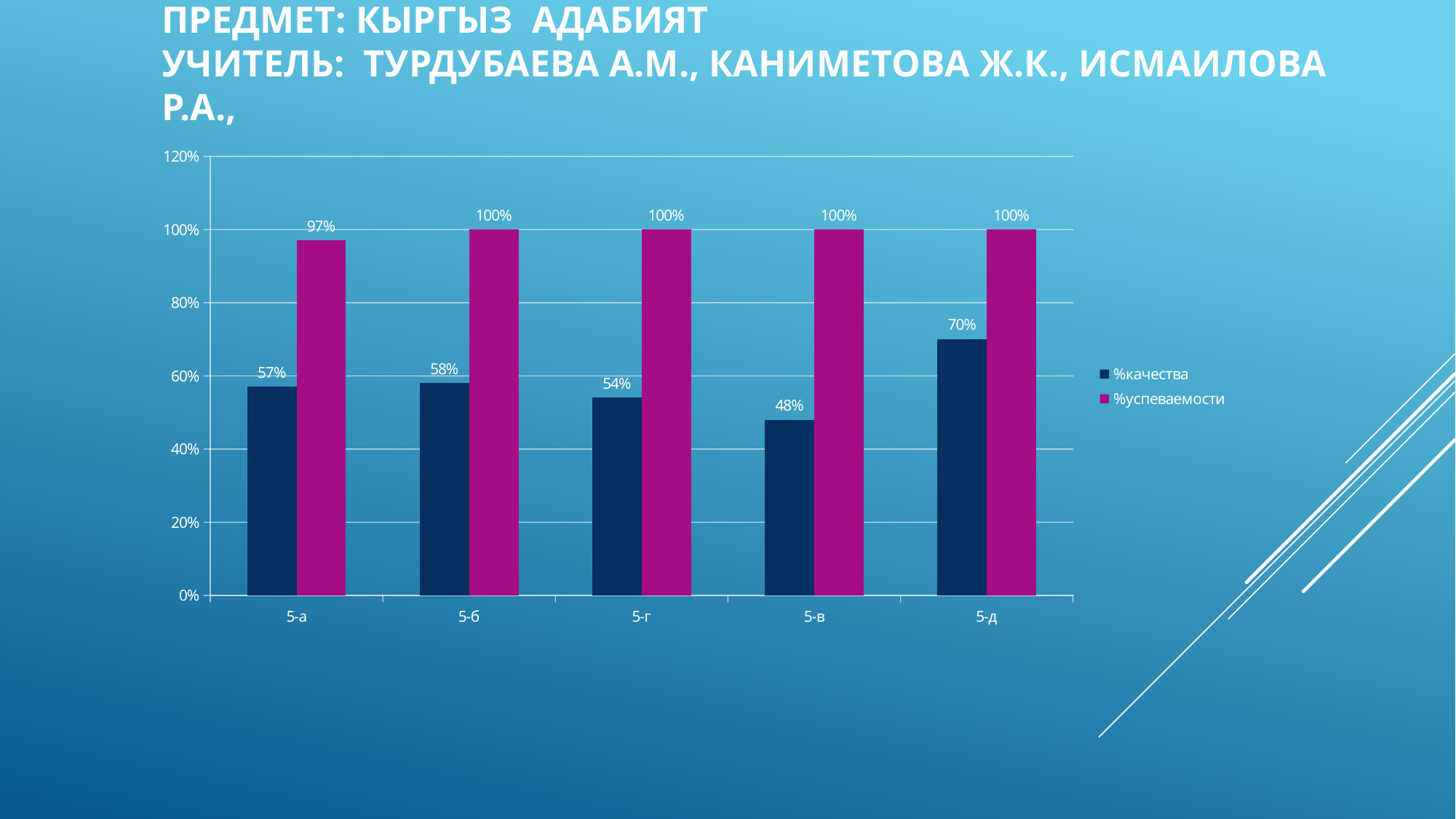
Which category has the highest %качества value? 5-д Which colour represents the %успеваемости series? magenta What kind of chart is shown on the slide? bar chart What is the %качества value for 5-а? 57% What is the difference between the %качества values for 5-д and 5-в? 22% Which category has the lowest %успеваемости value? 5-а Which category has the lowest %качества value? 5-в What is the %качества value for 5-в? 48% How many series does the legend list? 2 What is the %успеваемости value for 5-а? 97% How many categories are shown on the x axis? 5 Which is larger, the %качества value for 5-б or for 5-г? 5-б